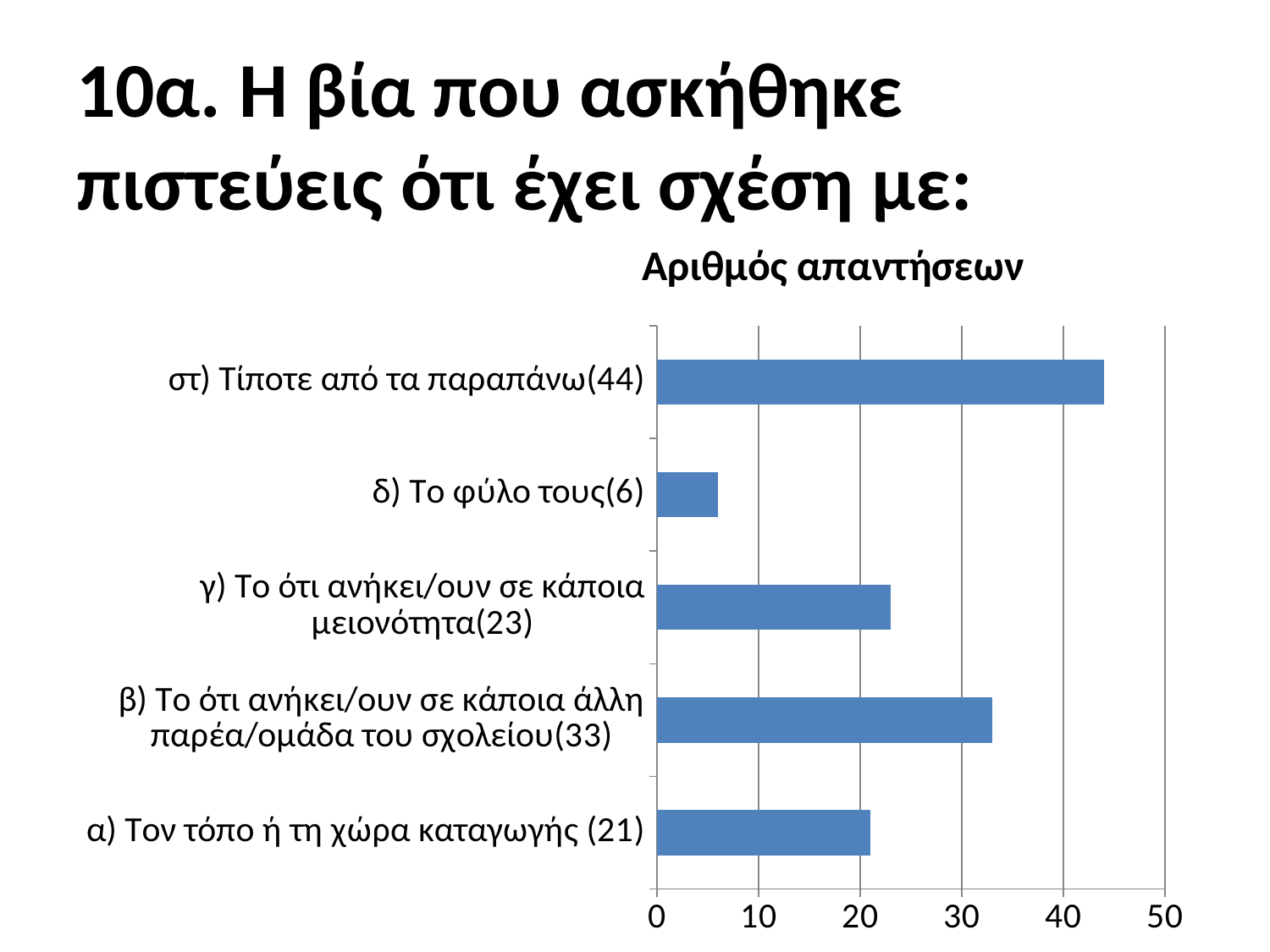
What is the number of responses for 'στ) Τίποτε από τα παραπάνω'? 44 Which category has the lowest number of responses? δ) Το φύλο τους What is the maximum value shown on the horizontal axis? 50 Which has more responses: 'γ) Το ότι ανήκει/ουν σε κάποια μειονότητα' or 'α) Τον τόπο ή τη χώρα καταγωγής'? γ) Το ότι ανήκει/ουν σε κάποια μειονότητα What is the number of responses for 'α) Τον τόπο ή τη χώρα καταγωγής'? 21 What type of chart is shown on the slide? bar chart Is the value for 'β) Το ότι ανήκει/ουν σε κάποια άλλη παρέα/ομάδα του σχολείου' greater or less than 30? greater What is the difference between the responses for 'β) Το ότι ανήκει/ουν σε κάποια άλλη παρέα/ομάδα του σχολείου' and 'γ) Το ότι ανήκει/ουν σε κάποια μειονότητα'? 10 Which category has the highest number of responses? στ) Τίποτε από τα παραπάνω What is the number of responses for 'δ) Το φύλο τους'? 6 What is the chart's title? Αριθμός απαντήσεων How many categories does the chart show? 5